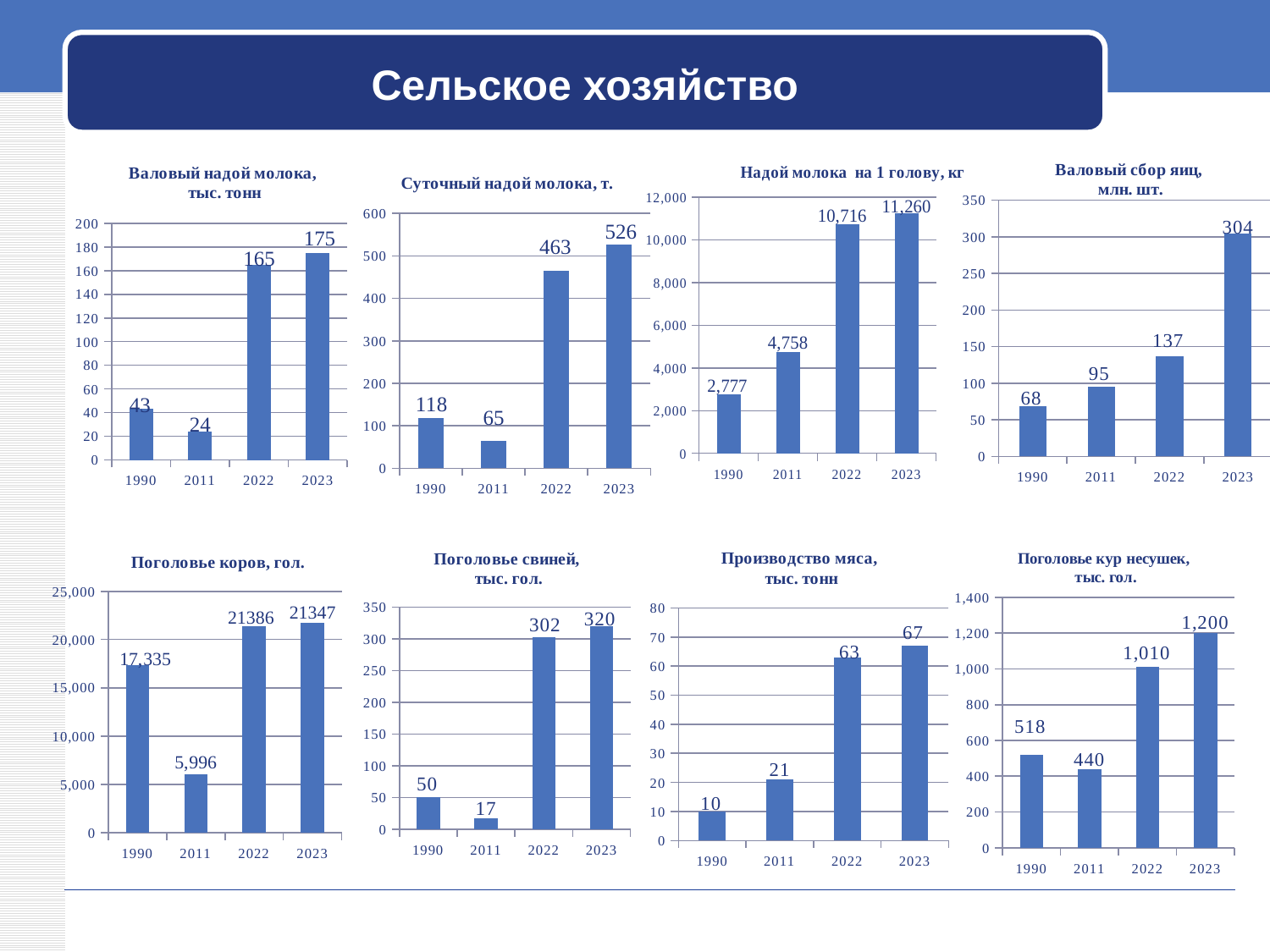
In the chart titled "Валовый надой молока, тыс. тонн", what is the value for 2023? 175 How many charts are shown on the slide? 8 In the chart titled "Валовый сбор яиц, млн. шт.", do the values rise or fall from 1990 to 2023? rise In the chart titled "Производство мяса, тыс. тонн", which is larger: the value for 2011 or the value for 1990? 2011 How many years (categories) are shown in the chart titled "Валовый надой молока, тыс. тонн"? 4 In the chart titled "Суточный надой молока, т.", what is the value for 2011? 65 In the chart titled "Валовый сбор яиц, млн. шт.", which year has the highest value? 2023 In the chart titled "Поголовье кур несушек, тыс. гол.", what is the value for 1990? 518 In the chart titled "Надой молока на 1 голову, кг", what is the value for 2022? 10,716 In the chart titled "Поголовье свиней, тыс. гол.", what is the difference between the values for 2023 and 2022? 18 What kind of chart is the one titled "Надой молока на 1 голову, кг"? bar chart In the chart titled "Поголовье коров, гол.", which year has the lowest value? 2011